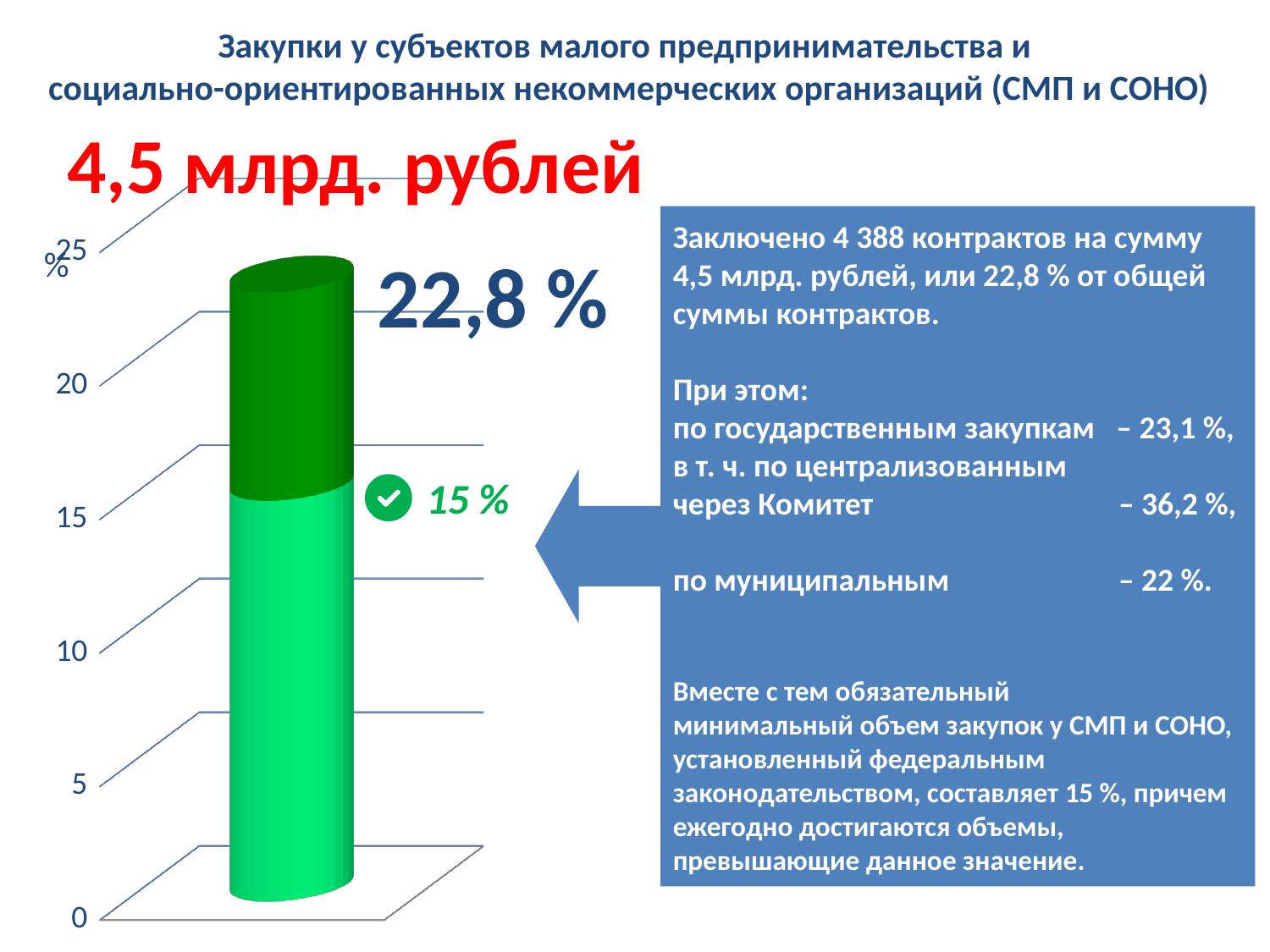
What percentage is marked with the green check mark next to the bar? 15 % Is the value of the bar greater or less than 25? less How many bars are plotted in the chart? 1 Is the value of the bar greater or less than 20? greater What is the highest tick value shown on the vertical axis of the chart? 25 What kind of chart is shown on the slide? bar chart Which of the two values shown on the chart is larger, 22,8 % or 15 %? 22,8 % What unit is indicated on the vertical axis of the chart? % By how many percentage points does the bar's value (22,8 %) exceed the 15 % mark? 7,8 % What value is labelled on the bar in the chart? 22,8 % Is the value of the bar greater or less than 15? greater